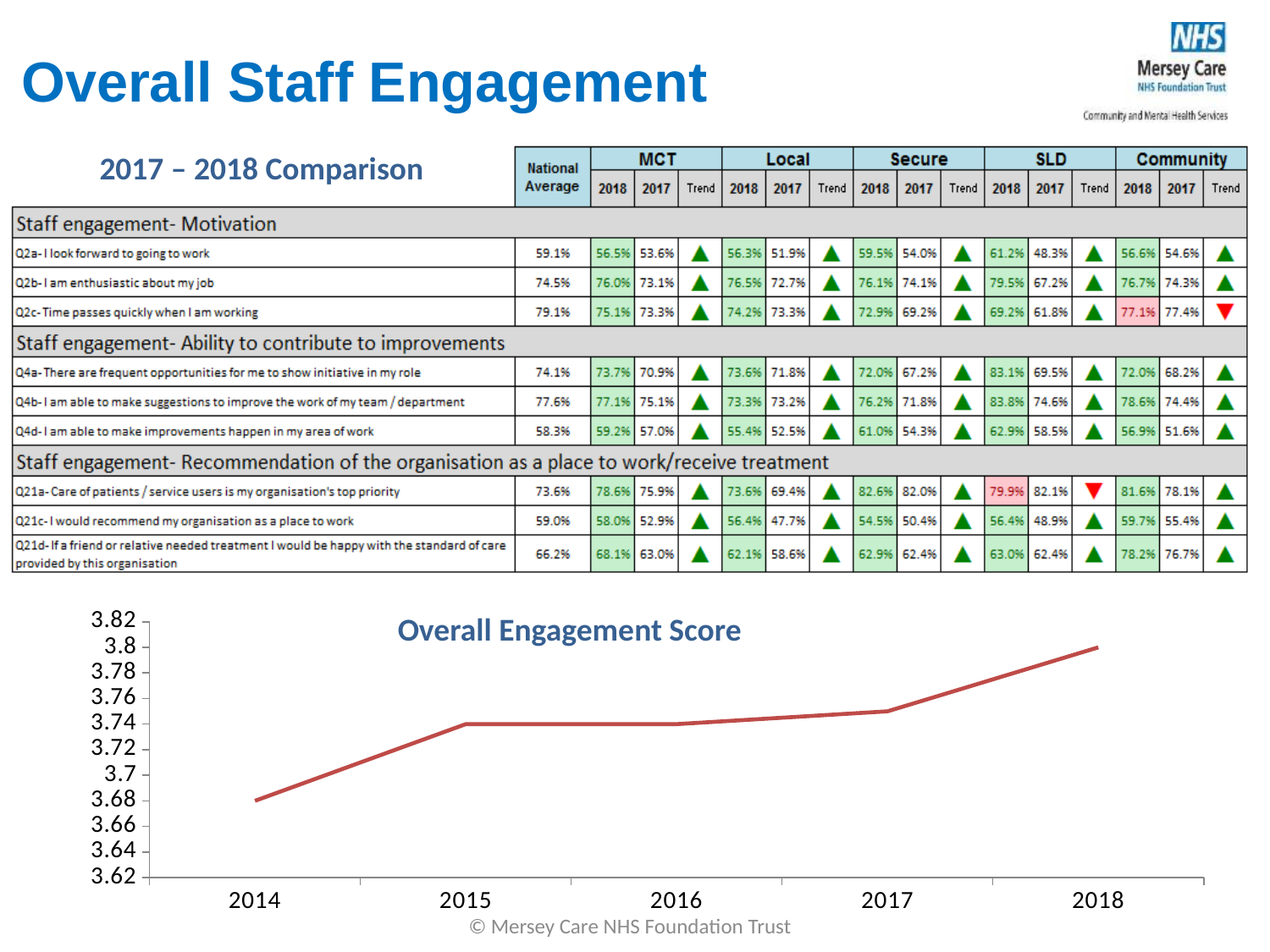
How many years are plotted on the Overall Engagement Score chart? 5 Is the Overall Engagement Score for 2014 greater or less than 3.7? less Is the Overall Engagement Score for 2017 greater or less than 3.7? greater Does the Overall Engagement Score rise or fall from 2014 to 2018? rise Which year has the larger Overall Engagement Score, 2015 or 2018? 2018 What kind of chart is the Overall Engagement Score chart? line chart What is the title of the line chart at the bottom of the slide? Overall Engagement Score Which year has the highest Overall Engagement Score? 2018 What is the first year shown on the x axis of the Overall Engagement Score chart? 2014 Is the Overall Engagement Score for 2016 greater or less than 3.76? less Which year has the lowest Overall Engagement Score? 2014